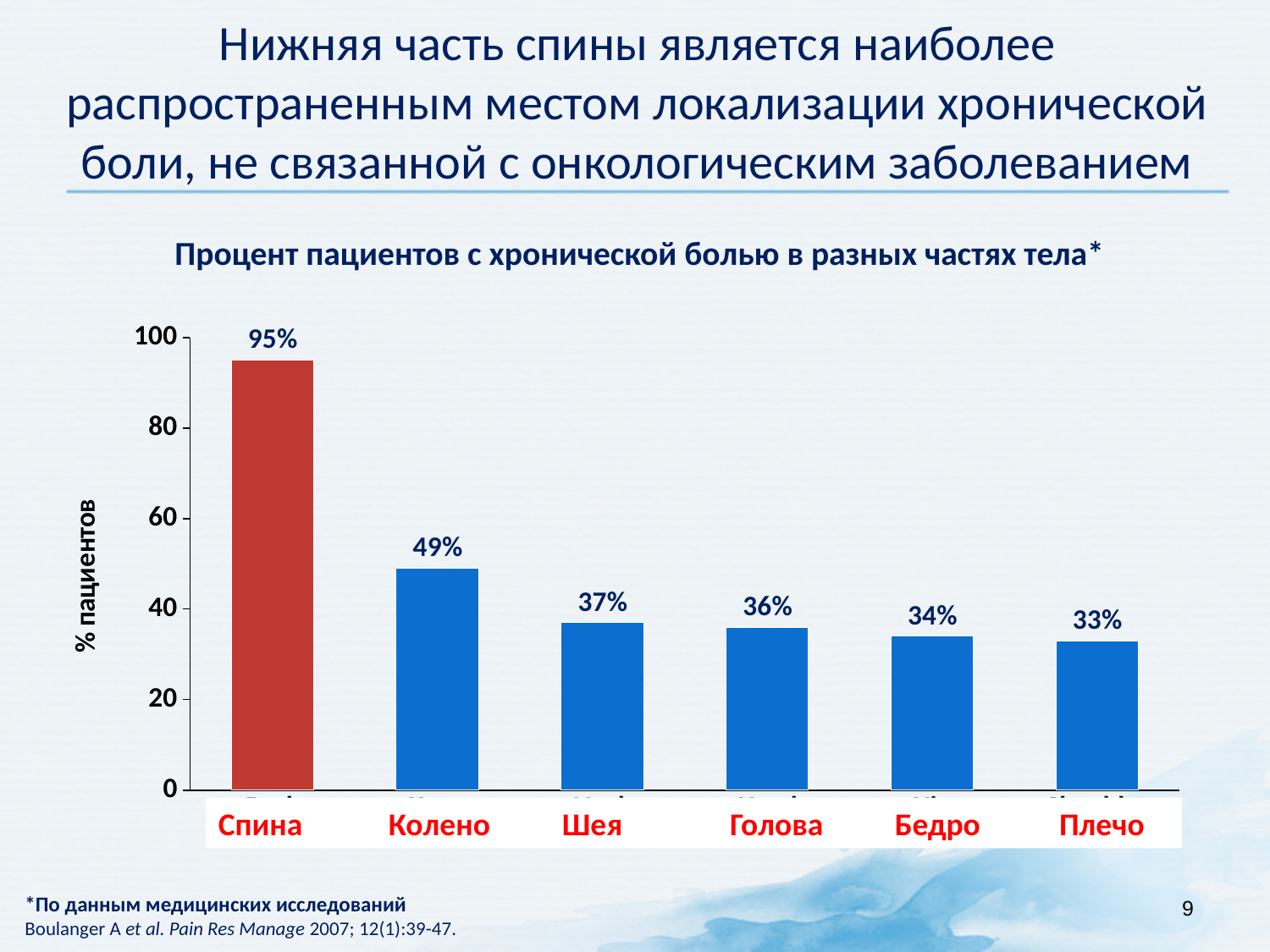
What is the value for Колено? 49% Which bar is coloured red rather than blue? Спина Which category has the lowest value? Плечо What is the value for Спина? 95% What is the difference between the values for Спина and Колено? 46% Which is larger, the value for Колено or the value for Шея? Колено What kind of chart is shown on the slide? Bar chart What is the value for Плечо? 33% What is the difference between the values for Шея and Бедро? 3% What is the value for Голова? 36% Which category has the highest value? Спина How many categories are shown in the chart? 6